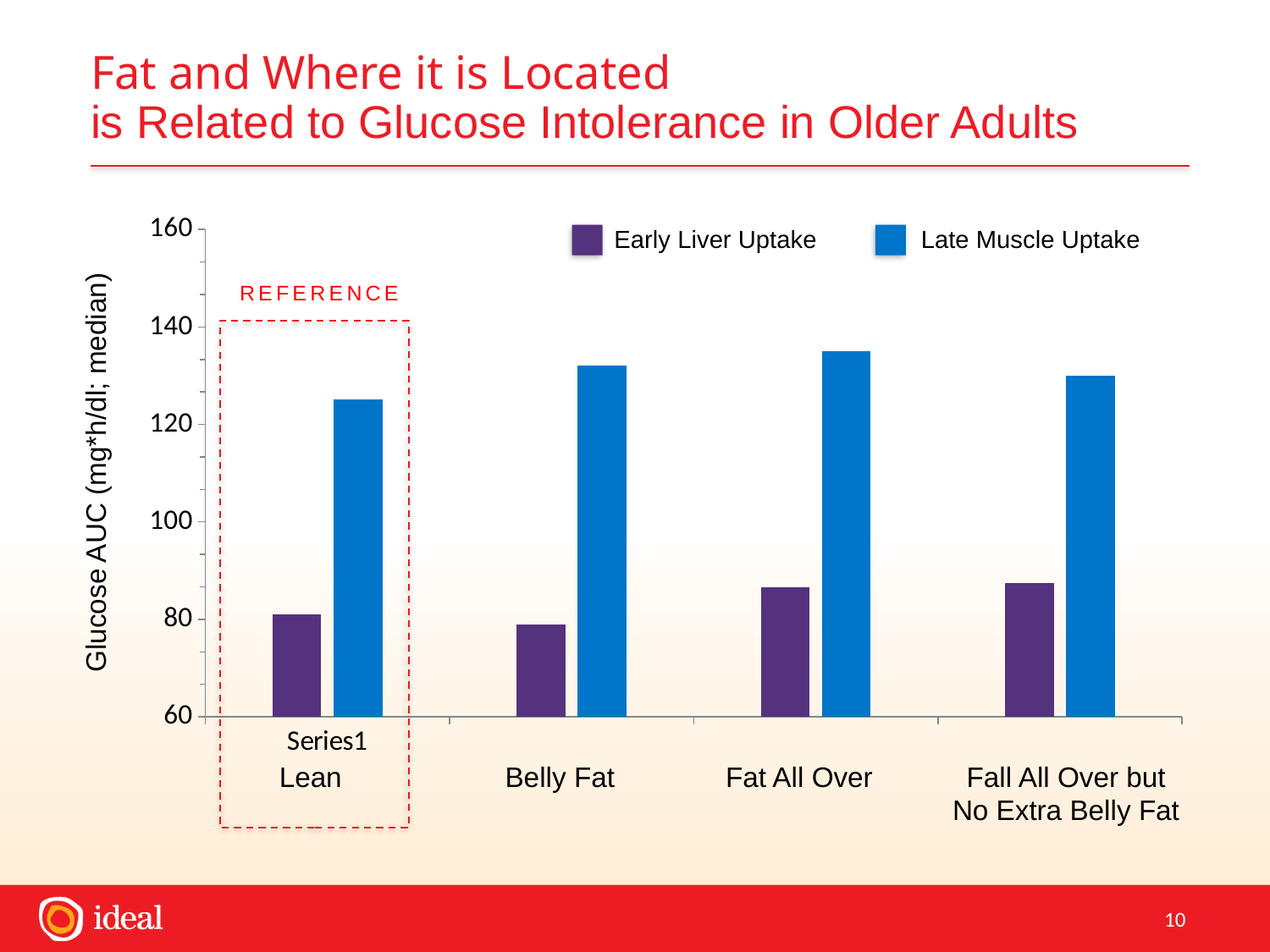
What kind of chart is shown on the slide? bar chart Which series is shown in blue in the chart? Late Muscle Uptake Which category has the lowest Late Muscle Uptake value? Lean Which is larger, the Early Liver Uptake value for Lean or for Fat All Over? Fat All Over Is the Early Liver Uptake value for Lean greater or less than 100? less Which is larger, the Late Muscle Uptake value for Lean or for Belly Fat? Belly Fat How many categories are shown on the x axis of the chart? 4 Is the Late Muscle Uptake value for Lean greater or less than 120? greater Which category is marked as the REFERENCE group in the chart? Lean How many series does the chart legend list? 2 Is the Early Liver Uptake value for Fall All Over but No Extra Belly Fat greater or less than 80? greater